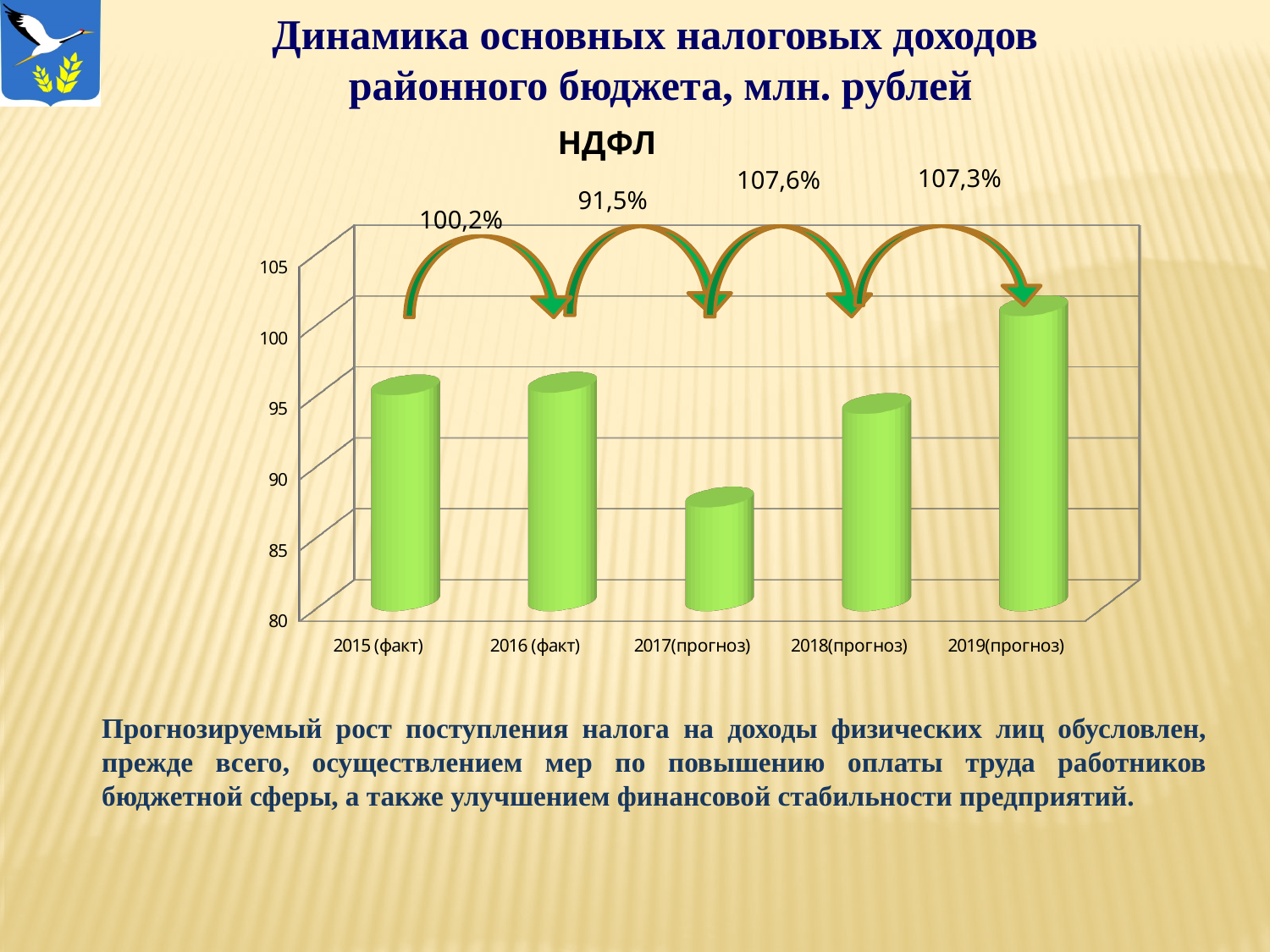
Is the value for 2018(прогноз) greater or less than 90? greater Which is larger, the value for 2019(прогноз) or the value for 2017(прогноз)? 2019(прогноз) Is the value for 2017(прогноз) greater or less than 90? less Is the value for 2019(прогноз) greater or less than 100? greater Which year has the lowest bar in the chart? 2017(прогноз) Which is larger, the value for 2018(прогноз) or the value for 2017(прогноз)? 2018(прогноз) How many categories (years) are shown on the x axis of the chart? 5 Do the bar values rise or fall from 2017(прогноз) to 2019(прогноз)? rise What is the title of the chart? НДФЛ Which year has the highest bar in the chart? 2019(прогноз) What kind of chart is shown on the slide? bar chart